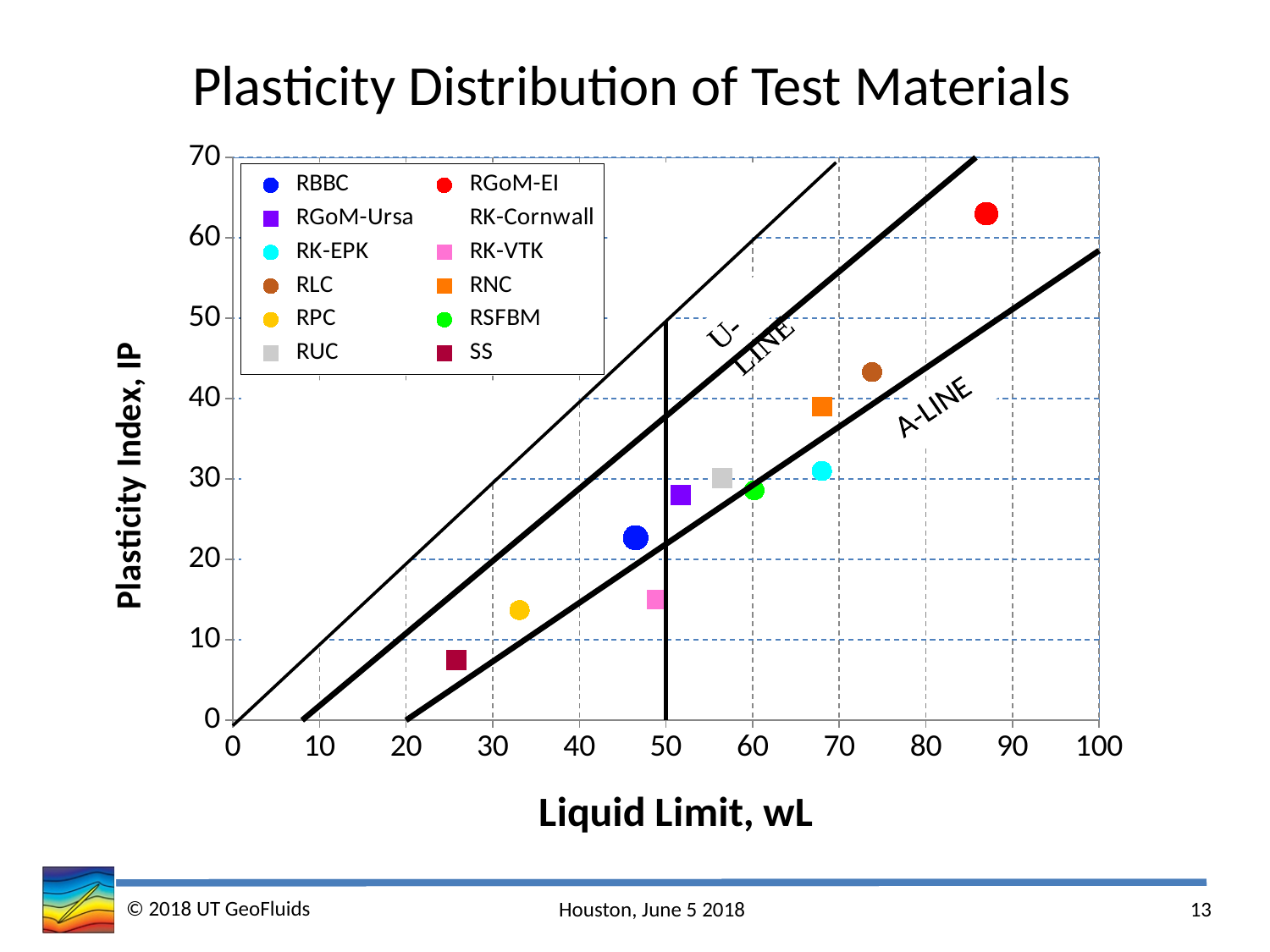
Which has the larger plasticity index, RNC or RK-EPK? RNC What is the title of the x axis? Liquid Limit, wL How many series does the legend list? 12 Is the plasticity index for RPC greater or less than 20? less What kind of chart is shown on the slide? scatter chart Is the liquid limit for RLC greater or less than 70? greater Which material has the highest plasticity index? RGoM-EI Is the plasticity index for RGoM-EI greater or less than 60? greater Which material has the lowest plasticity index? SS Which has the larger liquid limit, RBBC or RGoM-Ursa? RGoM-Ursa Which material has the highest liquid limit? RGoM-EI